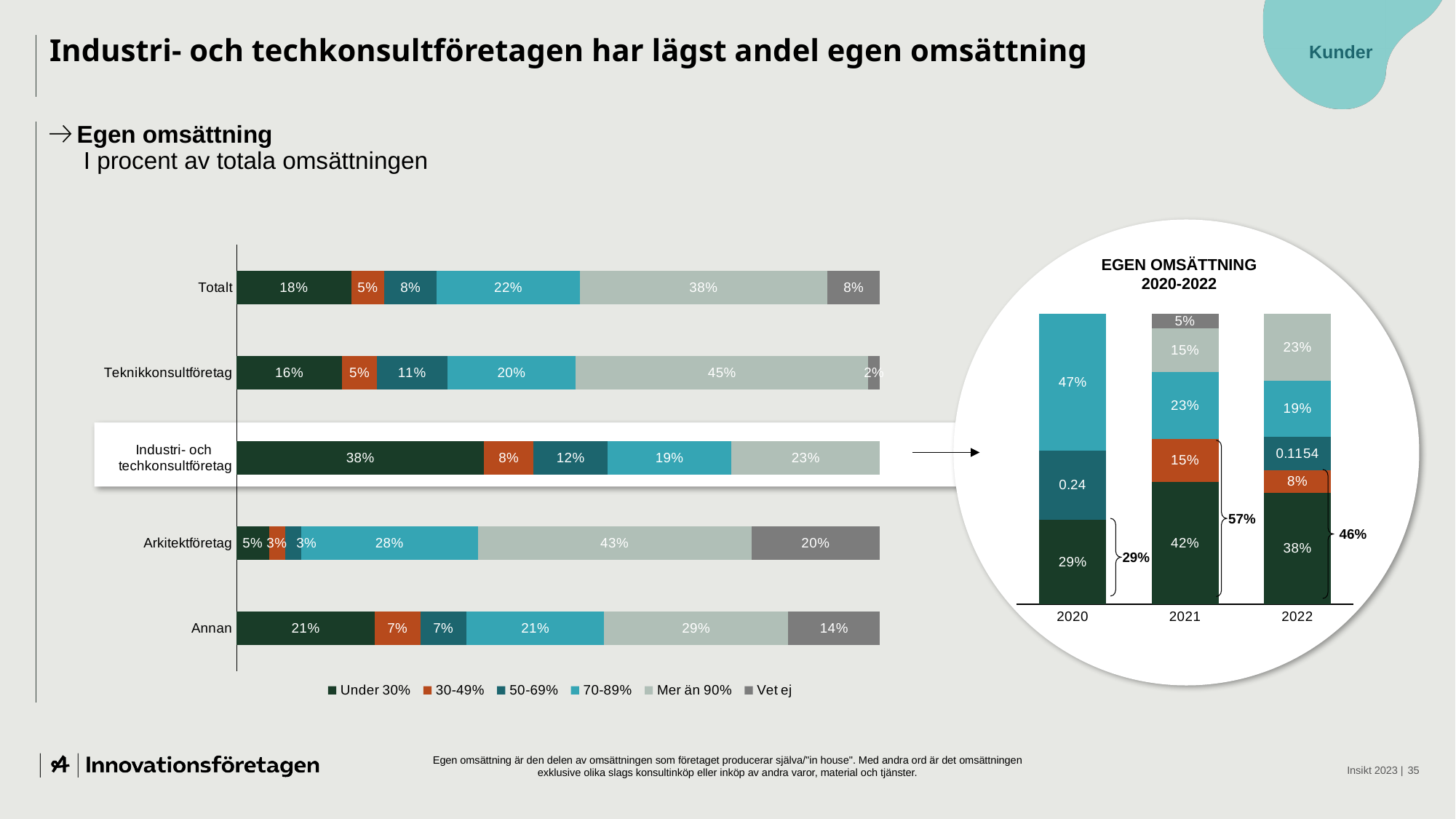
In the right chart (EGEN OMSÄTTNING 2020-2022), what bracketed value is shown next to the 2021 bar? 57% In the right chart (EGEN OMSÄTTNING 2020-2022), what is the value of the bottom (Under 30%) segment for 2021? 42% In the left chart, which has the larger '70-89%' value: Arkitektföretag or Totalt? Arkitektföretag In the left chart, which category has the highest 'Under 30%' share? Industri- och techkonsultföretag What kind of chart is the right chart titled 'EGEN OMSÄTTNING 2020-2022'? Stacked bar chart In the left chart (Egen omsättning, I procent av totala omsättningen), what is the value of the 'Under 30%' segment for Industri- och techkonsultföretag? 38% In the left chart, which category has the lowest 'Under 30%' share? Arkitektföretag How many categories are shown on the left chart? 5 In the left chart, what is the difference between the 'Vet ej' values for Arkitektföretag and Annan? 6 percentage points In the right chart (EGEN OMSÄTTNING 2020-2022), what is the value of the top segment of the 2020 bar? 47% In the left chart, what is the 'Mer än 90%' value for Teknikkonsultföretag? 45% How many series does the legend of the left chart list? 6